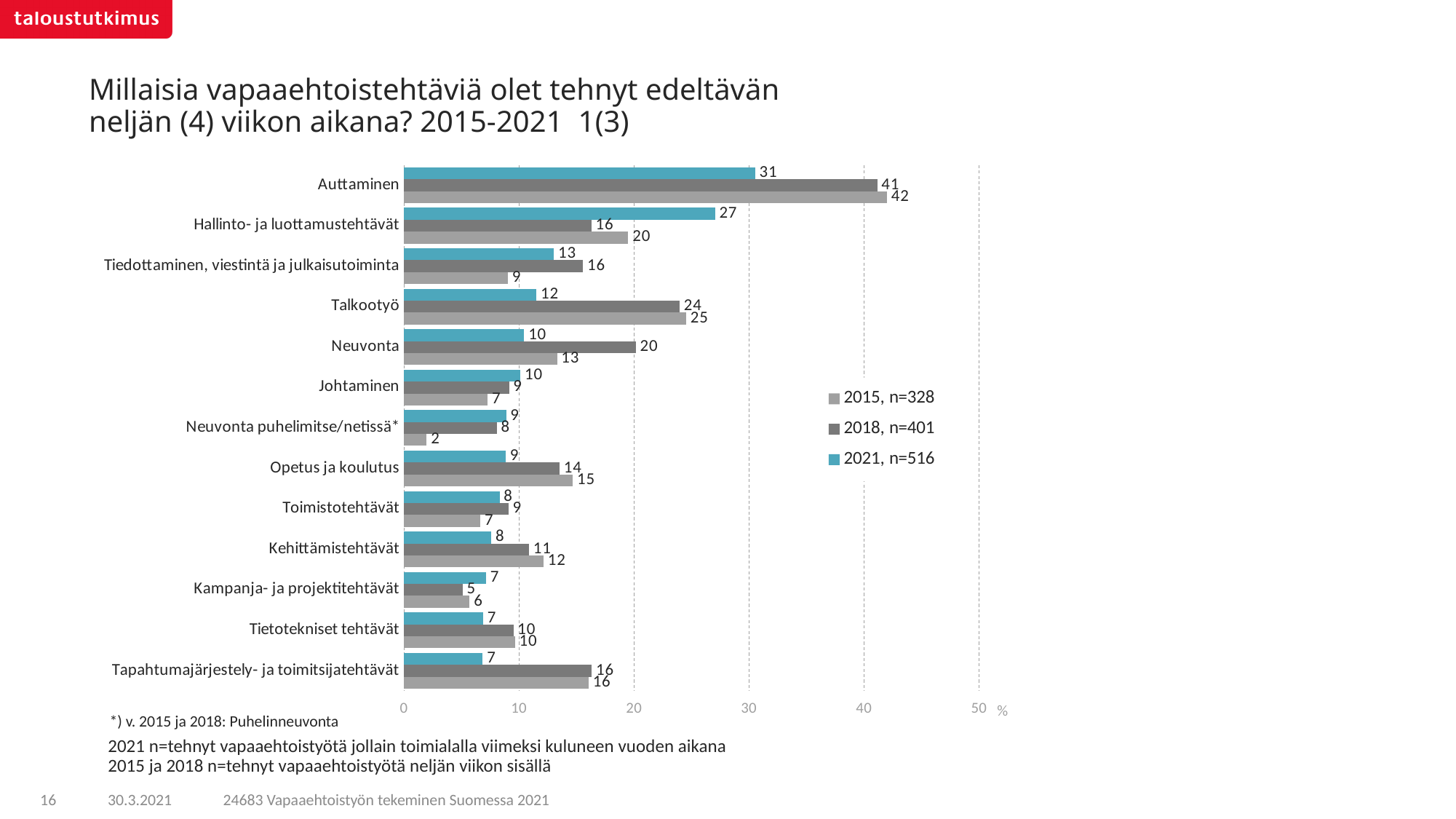
What is the 2021 value for Auttaminen? 31 Which is larger for Hallinto- ja luottamustehtävät: the 2021 value or the 2015 value? 2021 What is the difference between the 2018 and 2021 values for Talkootyö? 12 Which category has the lowest 2015 value? Neuvonta puhelimitse/netissä* What is the 2018 value for Neuvonta? 20 How many categories are shown in the chart? 13 What is the difference between the 2015 and 2021 values for Auttaminen? 11 What sample size (n) does the legend give for 2021? n=516 What is the 2015 value for Talkootyö? 25 What kind of chart is shown on the slide? Bar chart How many series does the legend list? 3 Which category has the highest 2021 value? Auttaminen